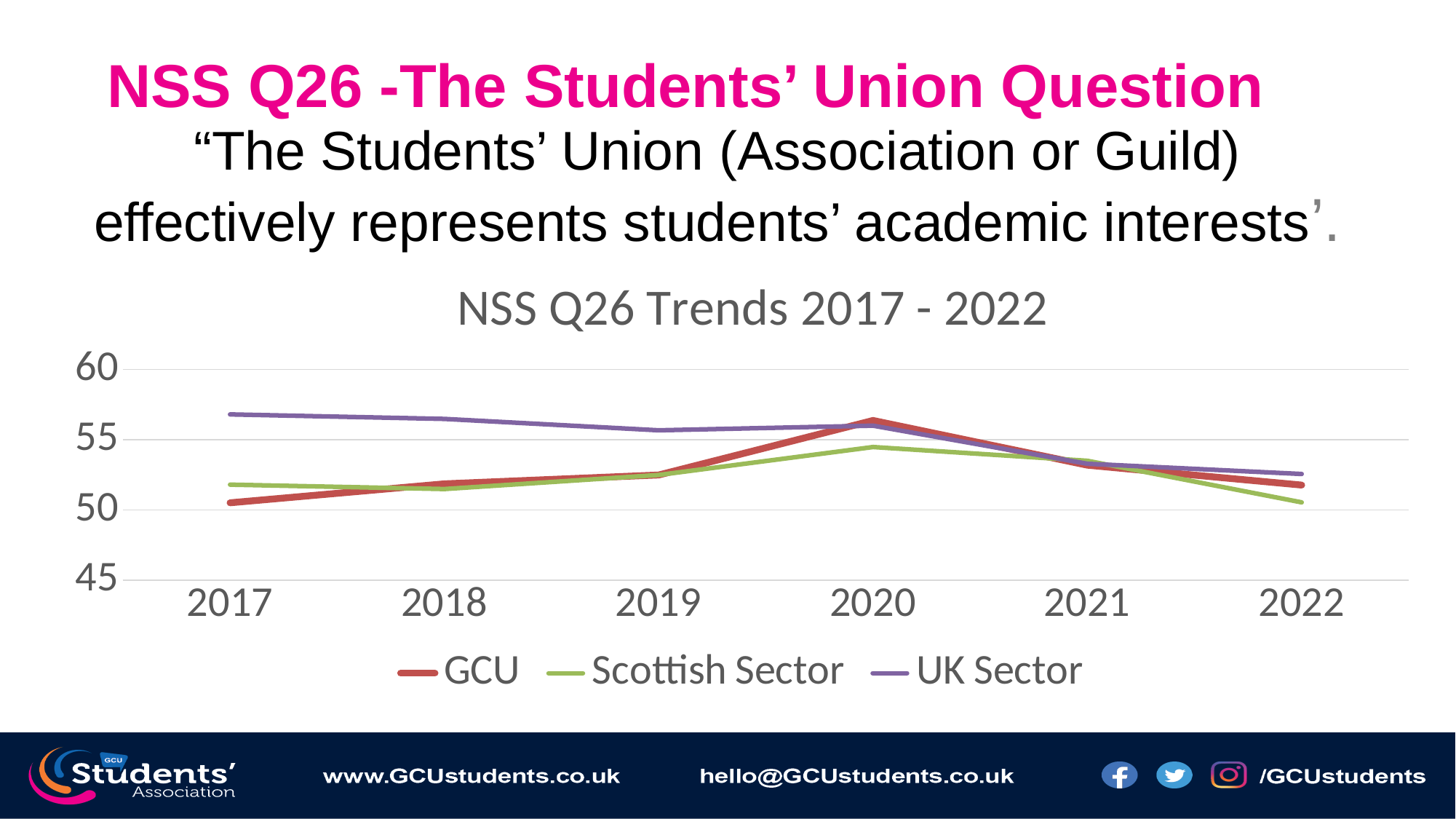
Is the value for GCU in 2017 greater or less than 55? less Does the UK Sector line rise or fall from 2017 to 2019? Fall In which year does the Scottish Sector line reach its lowest value? 2022 In 2017, which is higher: GCU or UK Sector? UK Sector Is the value for UK Sector in 2017 greater or less than 55? greater How many years are shown on the x axis? 6 How many series does the legend list? 3 What is the title of the chart? NSS Q26 Trends 2017 - 2022 What kind of chart is shown on the slide? Line chart In which year does the GCU line reach its highest value? 2020 Which series is drawn in green? Scottish Sector Does the GCU line rise or fall from 2020 to 2022? Fall